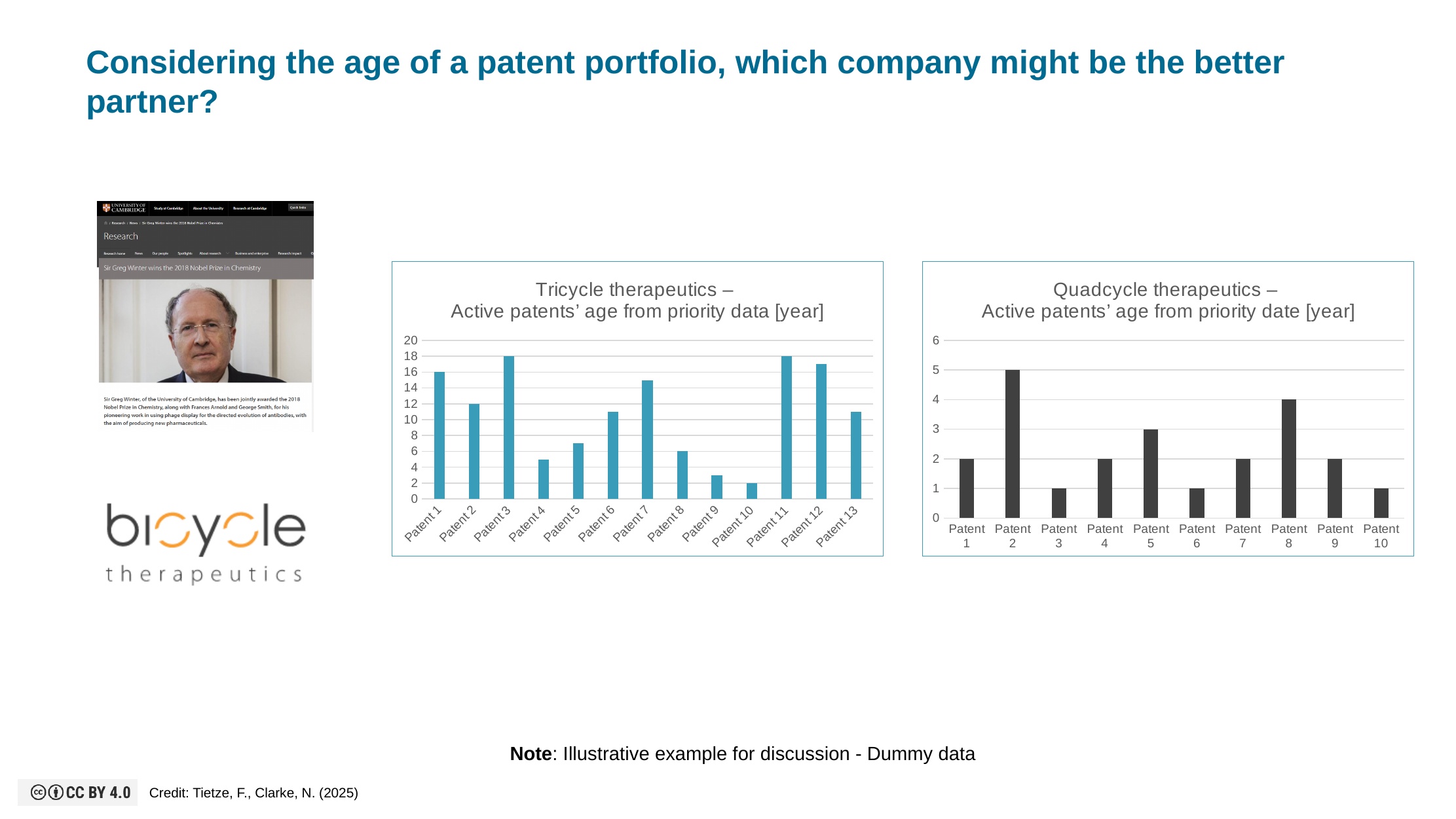
How many patents are shown in the Tricycle therapeutics chart? 13 In the Quadcycle therapeutics chart, what is the difference in age between Patent 2 and Patent 5? 2 What kind of chart is the Tricycle therapeutics chart? bar chart In the Tricycle therapeutics chart, what is the age of Patent 10? 2 In the Quadcycle therapeutics chart, which patent has the highest age? Patent 2 In the Quadcycle therapeutics chart, what is the age of Patent 8? 4 What is the maximum value shown on the vertical axis of the Quadcycle therapeutics chart? 6 In the Tricycle therapeutics chart, which is larger, the age of Patent 2 or Patent 4? Patent 2 In the Tricycle therapeutics chart, which patent has the lowest age? Patent 10 In the Tricycle therapeutics chart, is the value for Patent 7 greater or less than 14? greater How many patents are shown in the Quadcycle therapeutics chart? 10 In the Tricycle therapeutics chart, what is the age of Patent 1? 16